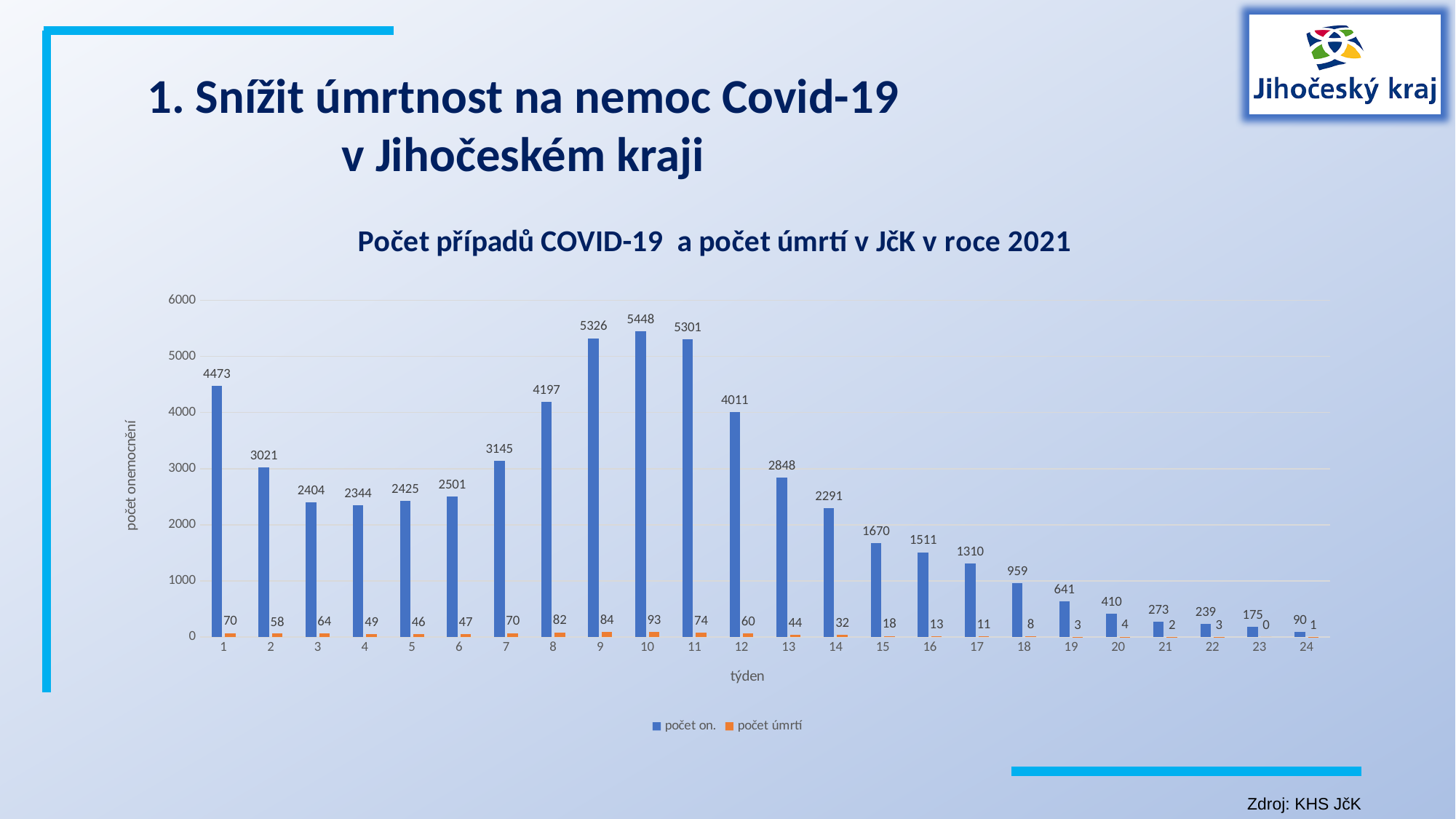
How many series does the legend list? 2 Which week has the highest 'počet on.' value? 10 What is the difference between 'počet on.' in week 9 and week 12? 1315 What kind of chart is shown on the slide? bar chart Which week has the lowest 'počet on.' value? 24 What is the value of 'počet on.' for week 10? 5448 Which week has the highest 'počet úmrtí' value? 10 Do the 'počet on.' values rise or fall from week 11 to week 24? fall Is the 'počet on.' value for week 8 greater or less than 4000? greater What is the value of 'počet úmrtí' for week 9? 84 Which is larger: 'počet on.' in week 2 or in week 7? week 7 How many weeks are shown on the x axis? 24